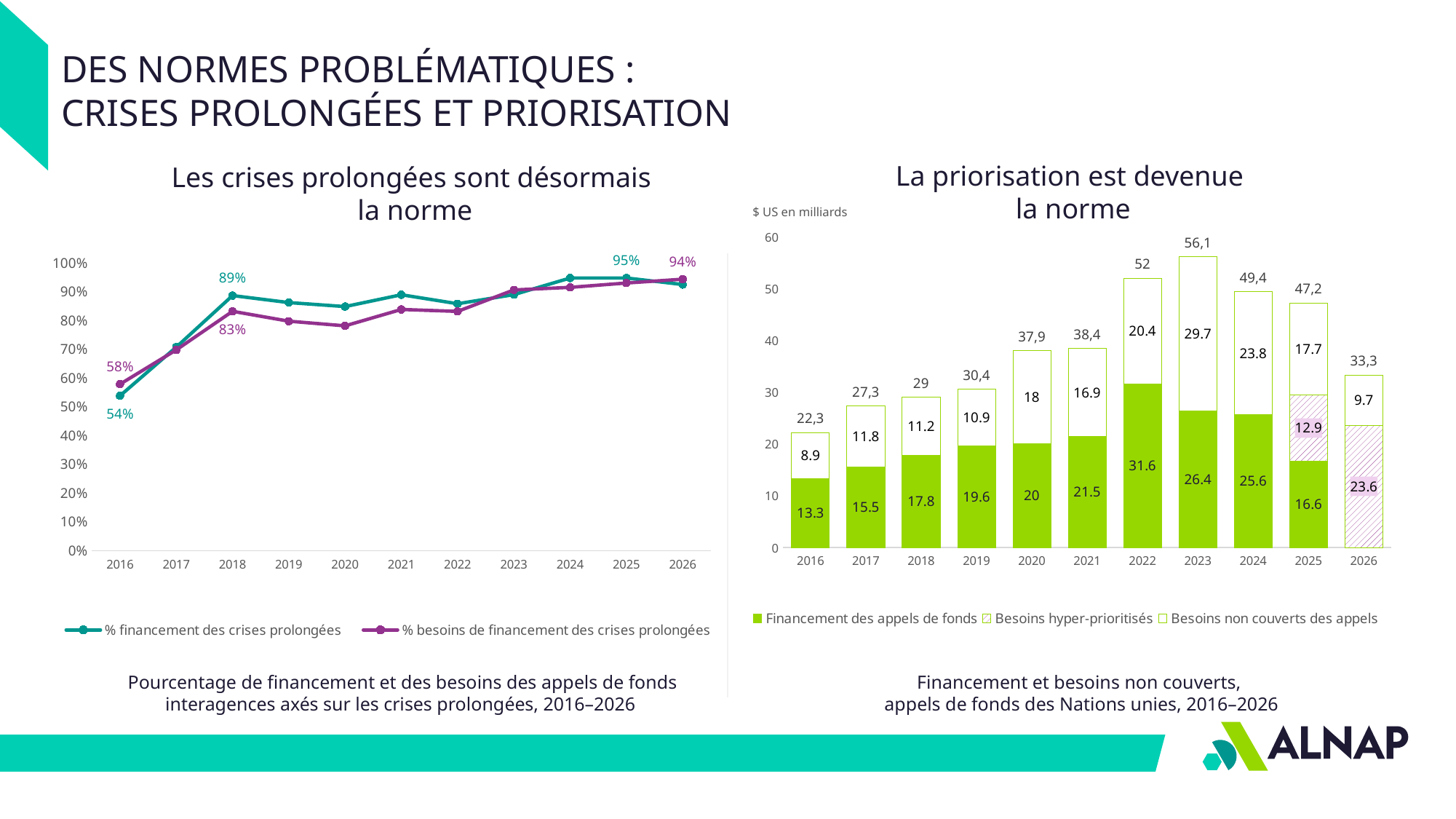
On the right chart 'La priorisation est devenue la norme', what is the total of the stacked bar for 2023? 56,1 On the right chart 'La priorisation est devenue la norme', what is the difference between 'Financement des appels de fonds' in 2022 and in 2023? 5.2 On the right chart 'La priorisation est devenue la norme', how many series does the legend list? 3 On the left chart 'Les crises prolongées sont désormais la norme', what is the value of '% besoins de financement des crises prolongées' in 2016? 58% On the right chart 'La priorisation est devenue la norme', which year has the lowest total? 2016 On the right chart 'La priorisation est devenue la norme', what kind of chart is shown? bar chart On the right chart 'La priorisation est devenue la norme', what is the value of 'Financement des appels de fonds' in 2022? 31.6 On the left chart 'Les crises prolongées sont désormais la norme', what is the value of '% financement des crises prolongées' in 2018? 89% On the left chart 'Les crises prolongées sont désormais la norme', in 2016 which series has the higher value, '% financement des crises prolongées' or '% besoins de financement des crises prolongées'? % besoins de financement des crises prolongées On the left chart 'Les crises prolongées sont désormais la norme', how many series does the legend list? 2 On the left chart 'Les crises prolongées sont désormais la norme', do the values generally rise or fall from 2016 to 2026? rise On the left chart 'Les crises prolongées sont désormais la norme', what kind of chart is shown? line chart